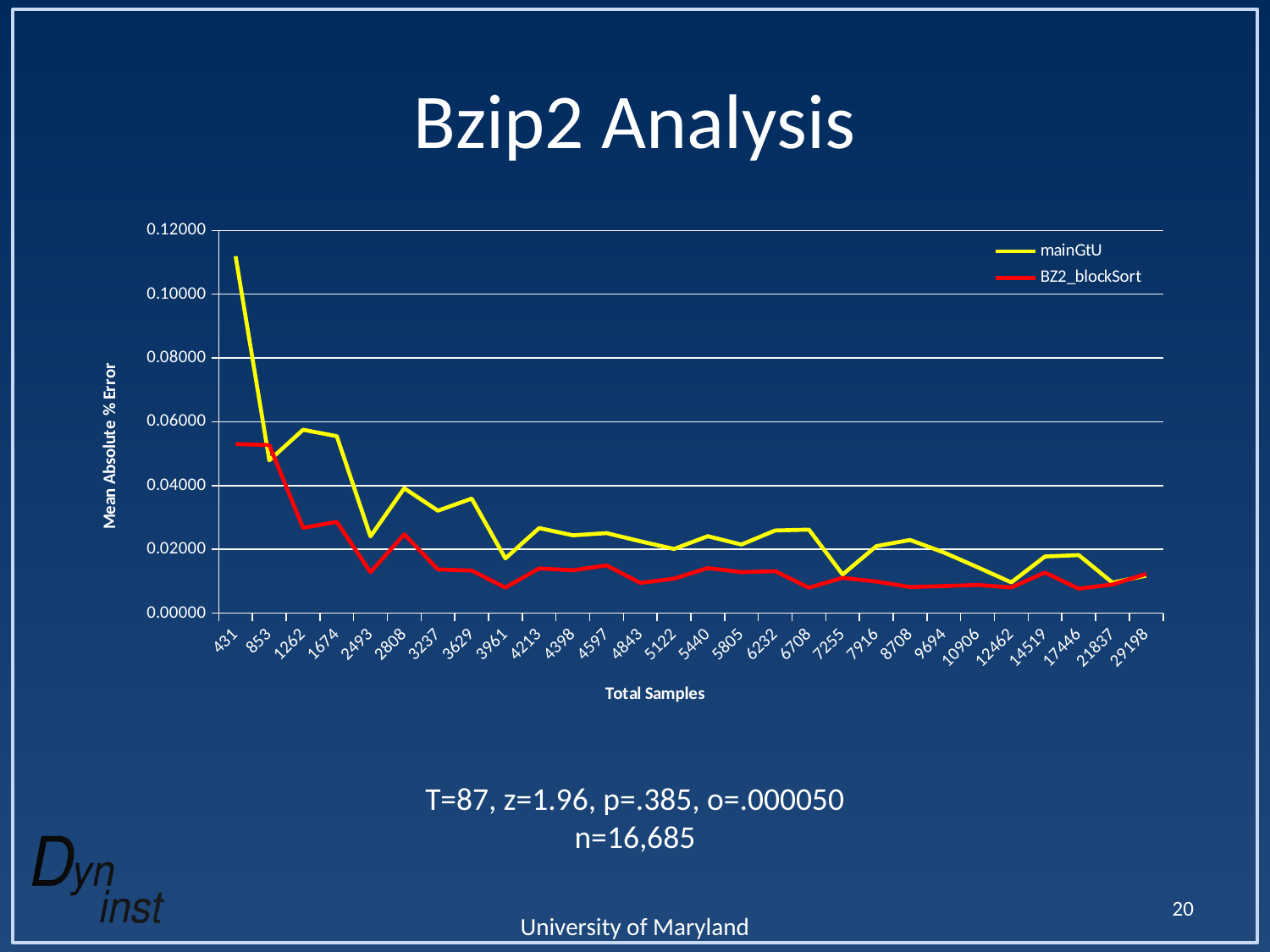
Is the BZ2_blockSort value at 431 total samples greater or less than 0.04000? greater How many Total Samples categories are shown along the x axis? 28 How many series does the chart legend list? 2 Is the BZ2_blockSort value at 3961 total samples greater or less than 0.02000? less Which colour is used for the mainGtU series? yellow At which Total Samples value does the mainGtU series reach its highest Mean Absolute % Error? 431 Does the mainGtU series generally rise or fall as Total Samples increases? fall Is the mainGtU value at 431 total samples greater or less than 0.10000? greater At 2808 total samples, which series has the higher Mean Absolute % Error, mainGtU or BZ2_blockSort? mainGtU What is the label of the y axis? Mean Absolute % Error What kind of chart is shown on the slide? line chart